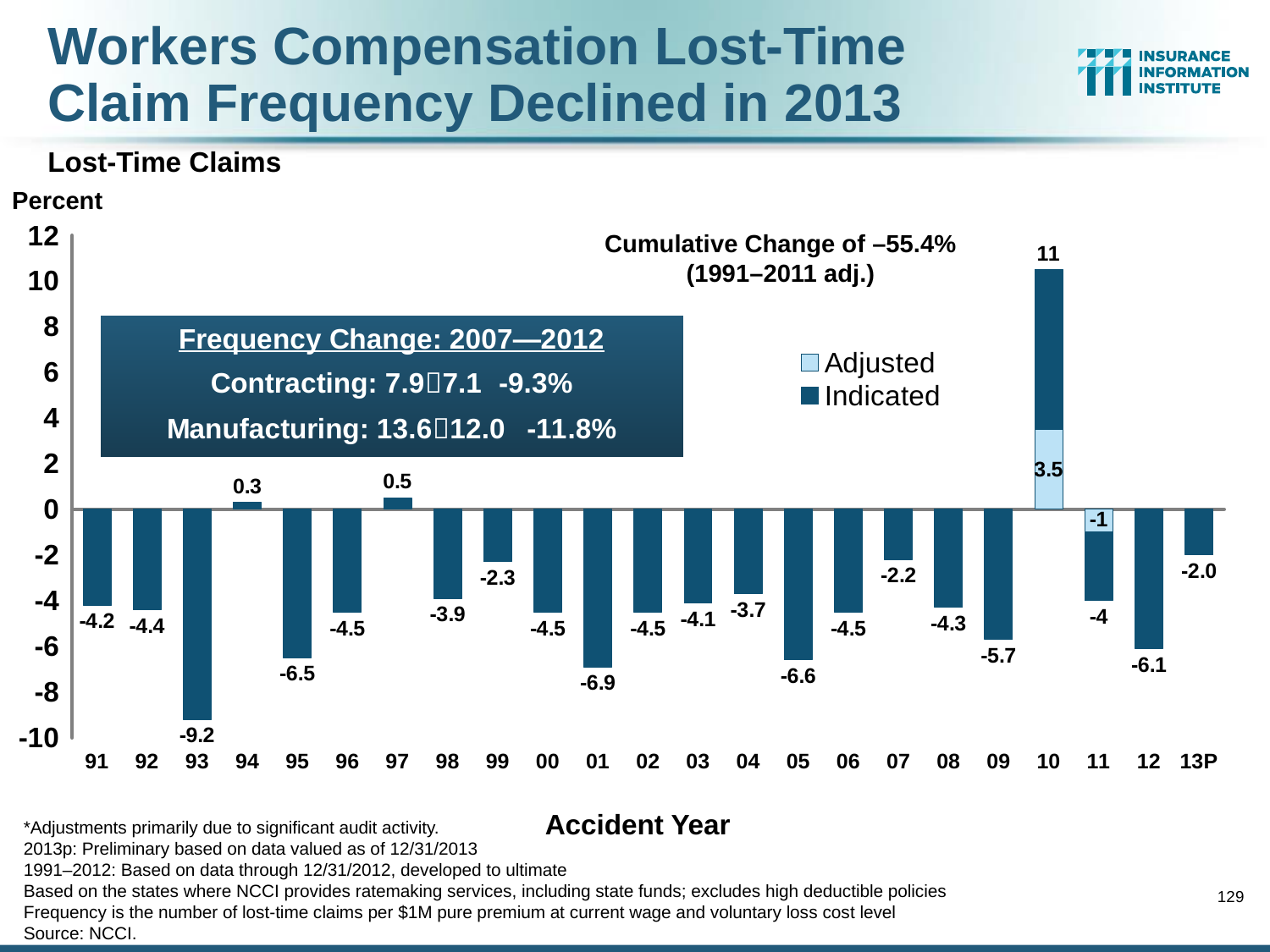
What is the difference between the values for accident years 93 and 13P? 7.2 Which accident year shows the larger decline, 95 or 12? 95 Which accident year has the lowest value? 93 What is the value for accident year 93? -9.2 What kind of chart is shown on the slide? Bar chart What is the Indicated value for accident year 10? 11 What are the two entries in the chart legend? Adjusted and Indicated Which accident year has the highest value? 10 How many series does the legend list? 2 What is the value for accident year 13P? -2.0 What is the Adjusted value for accident year 10? 3.5 How many accident years are shown on the x axis? 23